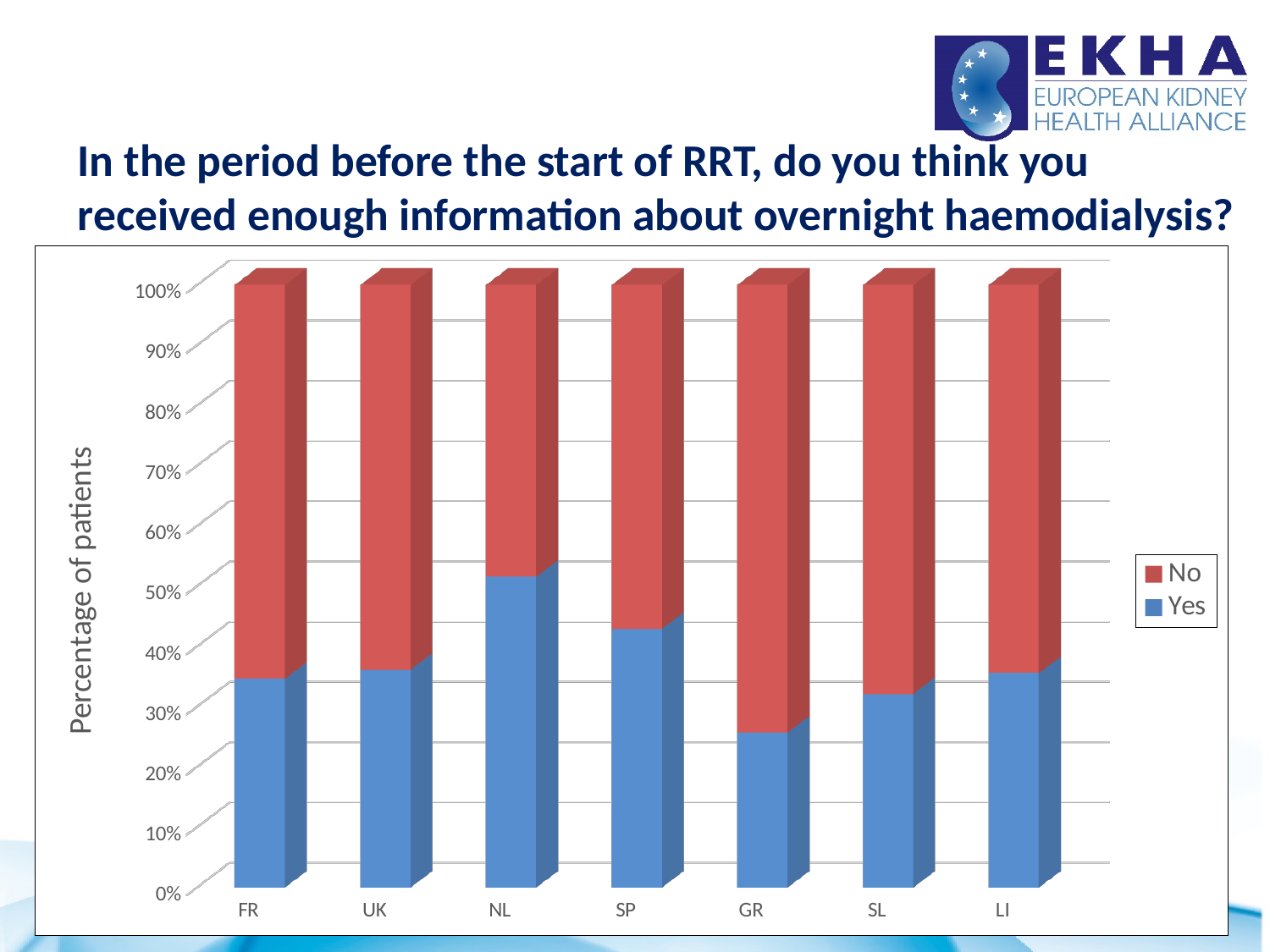
Is the 'No' value for GR greater or less than 70%? greater Which country has the lowest share of 'Yes' responses? GR Which country has a larger 'Yes' share, SP or UK? SP Is the 'Yes' value for GR greater or less than 30%? less How many series does the chart legend list? 2 How many countries are shown on the x axis of the chart? 7 What kind of chart is shown on the slide? Stacked bar chart Is the 'Yes' value for FR greater or less than 40%? less What is the label on the vertical axis of the chart? Percentage of patients What is the total height of the stacked bar for FR? 100% Which country has the highest share of 'Yes' responses? NL